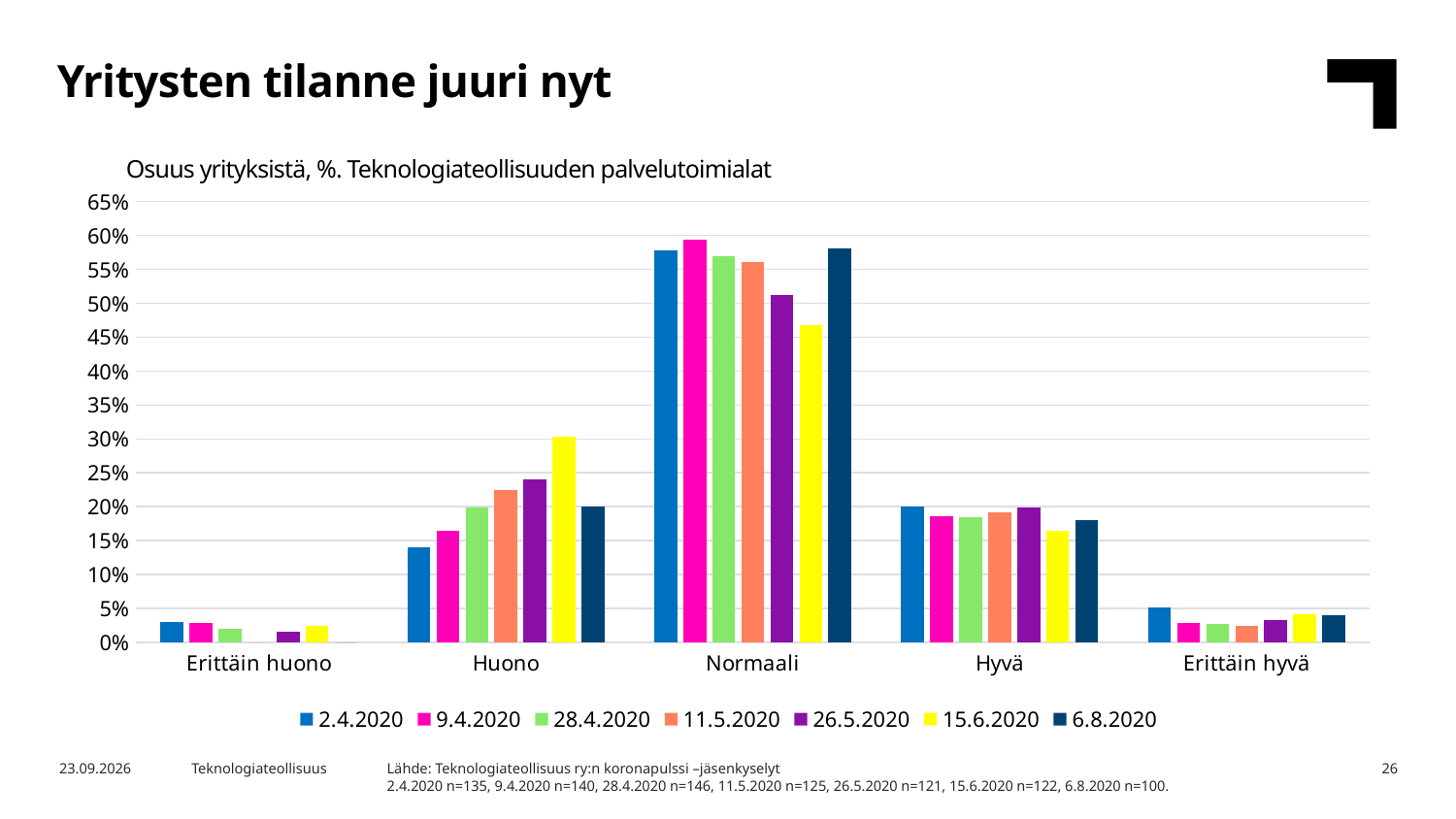
What is the subtitle text shown above the chart? Osuus yrityksistä, %. Teknologiateollisuuden palvelutoimialat For the Normaali category, which is larger: the 26.5.2020 value or the 15.6.2020 value? 26.5.2020 Is the value for Huono in the 15.6.2020 series greater or less than 25%? greater For the 2.4.2020 series, which category has the highest value? Normaali Is the value for Normaali in the 15.6.2020 series greater or less than 50%? less What kind of chart is shown on the slide? Bar chart For the Huono category, do the values rise or fall from the 2.4.2020 series through the 15.6.2020 series? rise Within the Huono category, which series has the lowest value? 2.4.2020 Is the value for Normaali in the 9.4.2020 series greater or less than 55%? greater How many categories are shown on the x axis? 5 How many series does the legend list? 7 For the Huono category, which is larger: the 2.4.2020 value or the 15.6.2020 value? 15.6.2020